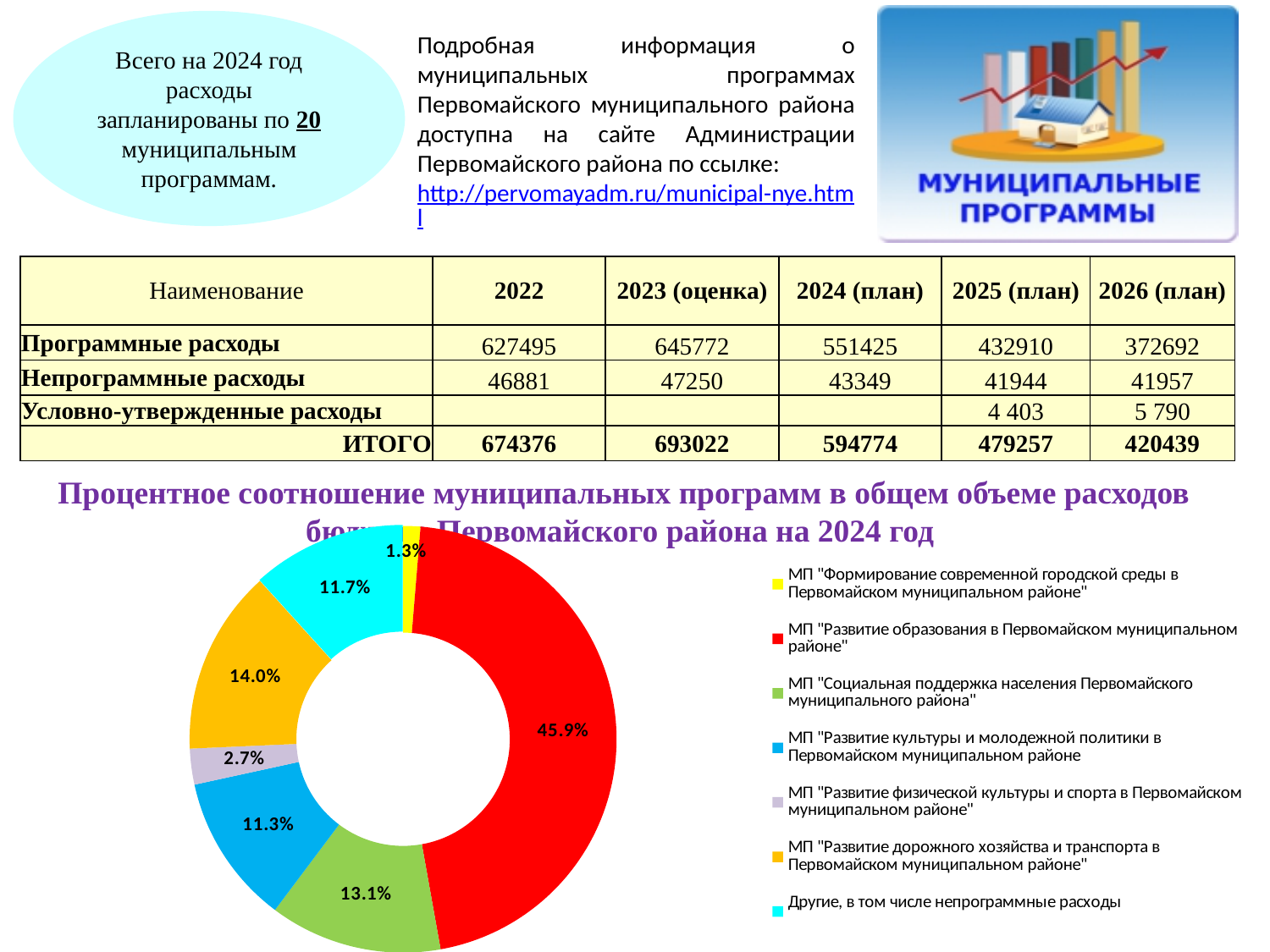
What is the difference between the shares of МП "Развитие дорожного хозяйства и транспорта" and МП "Развитие культуры и молодежной политики"? 2.7% What share is shown for МП "Социальная поддержка населения Первомайского муниципального района"? 13.1% How many categories does the legend of the chart list? 7 Which colour represents МП "Развитие образования в Первомайском муниципальном районе" in the chart? Red What share is shown for МП "Развитие культуры и молодежной политики в Первомайском муниципальном районе"? 11.3% Which category has the smallest share in the chart? МП "Формирование современной городской среды в Первомайском муниципальном районе" What share is shown for "Другие, в том числе непрограммные расходы"? 11.7% What share is shown for МП "Развитие дорожного хозяйства и транспорта в Первомайском муниципальном районе"? 14.0% What kind of chart is shown on the slide? Doughnut (pie) chart Which category has the largest share in the chart? МП "Развитие образования в Первомайском муниципальном районе" What share is shown for МП "Развитие физической культуры и спорта в Первомайском муниципальном районе"? 2.7% What share of the chart does МП "Развитие образования в Первомайском муниципальном районе" have? 45.9%